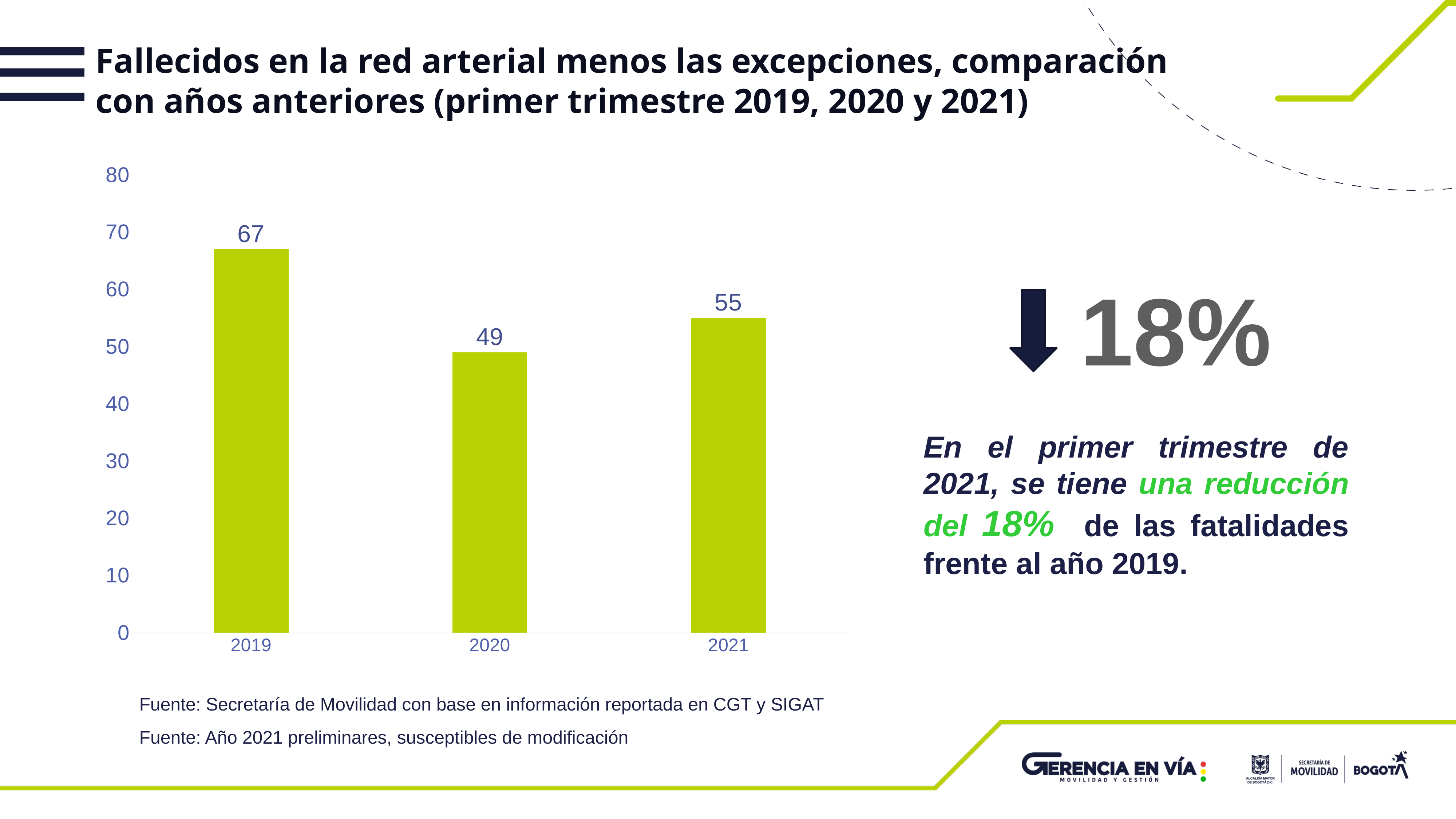
What kind of chart is shown on the slide? bar chart What is the value for 2020? 49 Which is larger, the value for 2020 or the value for 2021? 2021 How many years are shown on the x axis? 3 What is the value for 2019? 67 Is the value for 2019 greater or less than 60? greater What percentage reduction is highlighted next to the chart? 18% What is the difference between the values for 2021 and 2020? 6 Which year has the lowest value? 2020 Which year has the highest value? 2019 What is the difference between the values for 2019 and 2021? 12 What is the value for 2021? 55